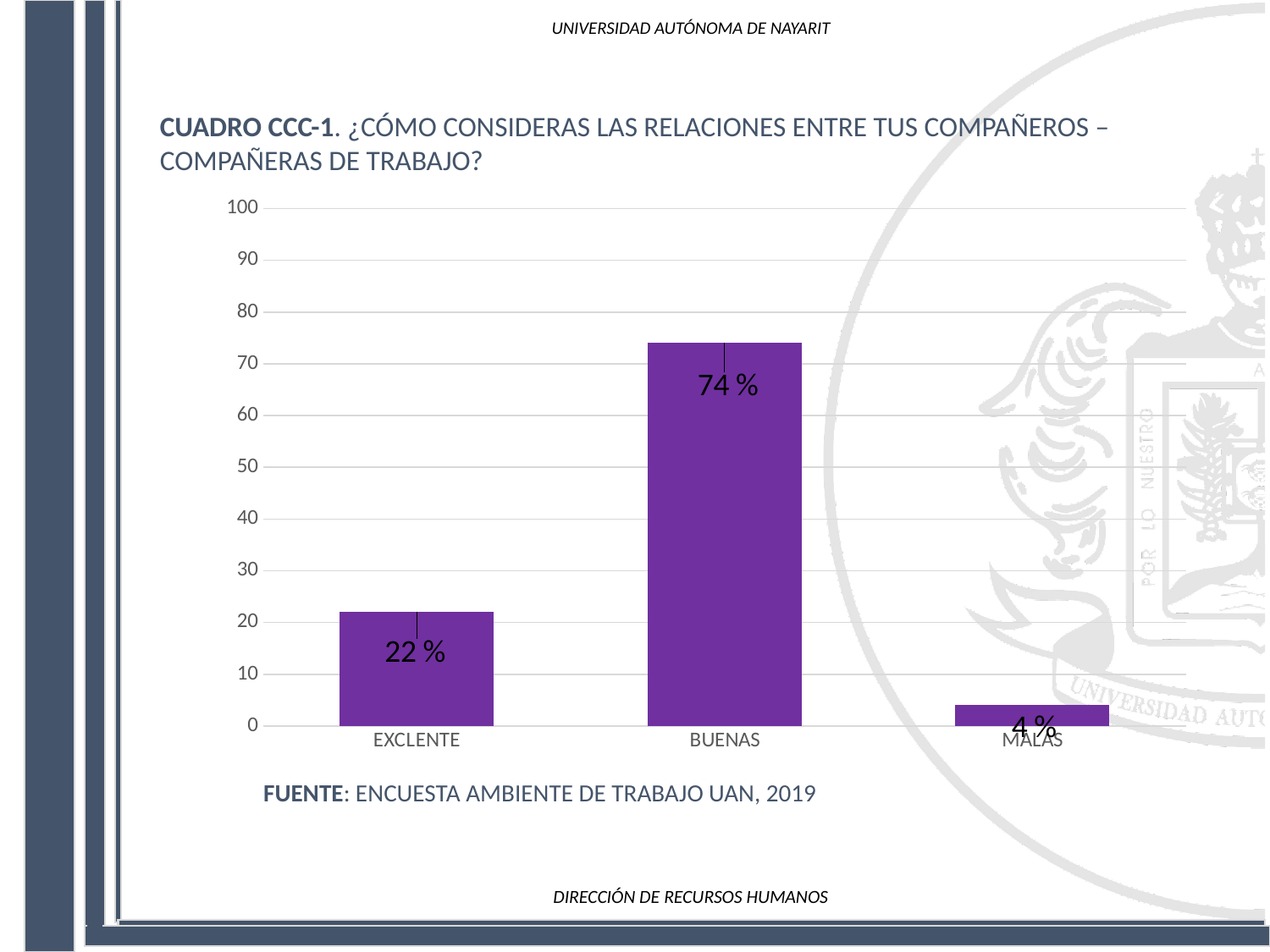
What is the difference between the values for BUENAS and EXCLENTE? 52 % Which category has the highest value? BUENAS What source is cited below the chart? ENCUESTA AMBIENTE DE TRABAJO UAN, 2019 What kind of chart is shown on the slide? bar chart Is the value for BUENAS greater or less than 70? greater What is the difference between the values for EXCLENTE and MALAS? 18 % What is the value for EXCLENTE? 22 % Which is larger, the value for EXCLENTE or the value for MALAS? EXCLENTE How many categories are shown on the x axis? 3 Which category has the lowest value? MALAS What is the value for MALAS? 4 % What is the value for BUENAS? 74 %